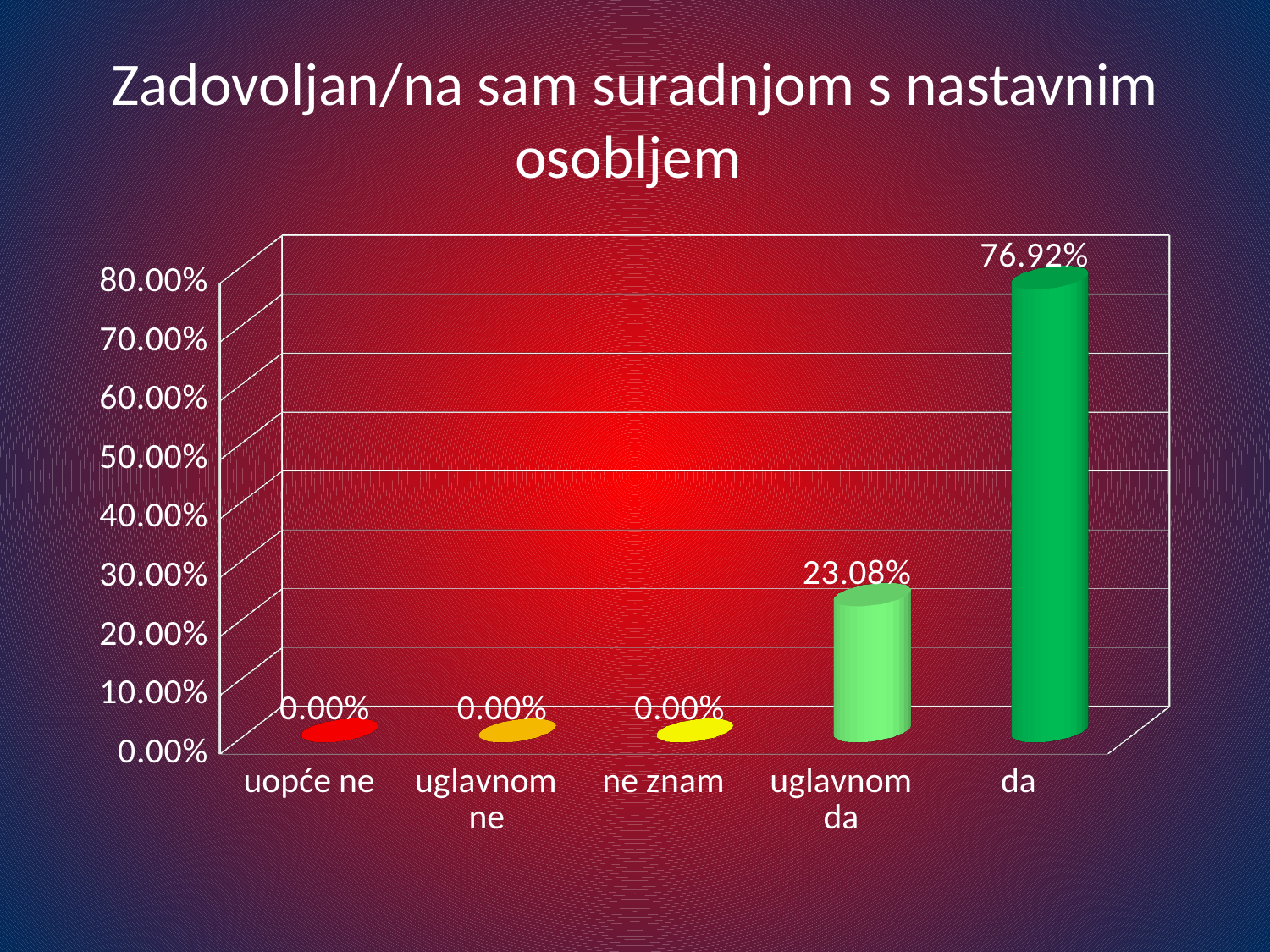
Is the value for "uglavnom da" greater or less than 30.00%? less Which category has the highest value? da What is the value for "da"? 76.92% How many categories are shown on the x axis? 5 What is the value for "ne znam"? 0.00% What is the value for "uglavnom da"? 23.08% What is the difference between the values for "da" and "uglavnom da"? 53.84% Which is larger, the value for "uglavnom da" or the value for "da"? da Is the value for "da" greater or less than 70.00%? greater How many categories have a value of 0.00%? 3 What kind of chart is shown on the slide? bar chart What is the title of the chart? Zadovoljan/na sam suradnjom s nastavnim osobljem